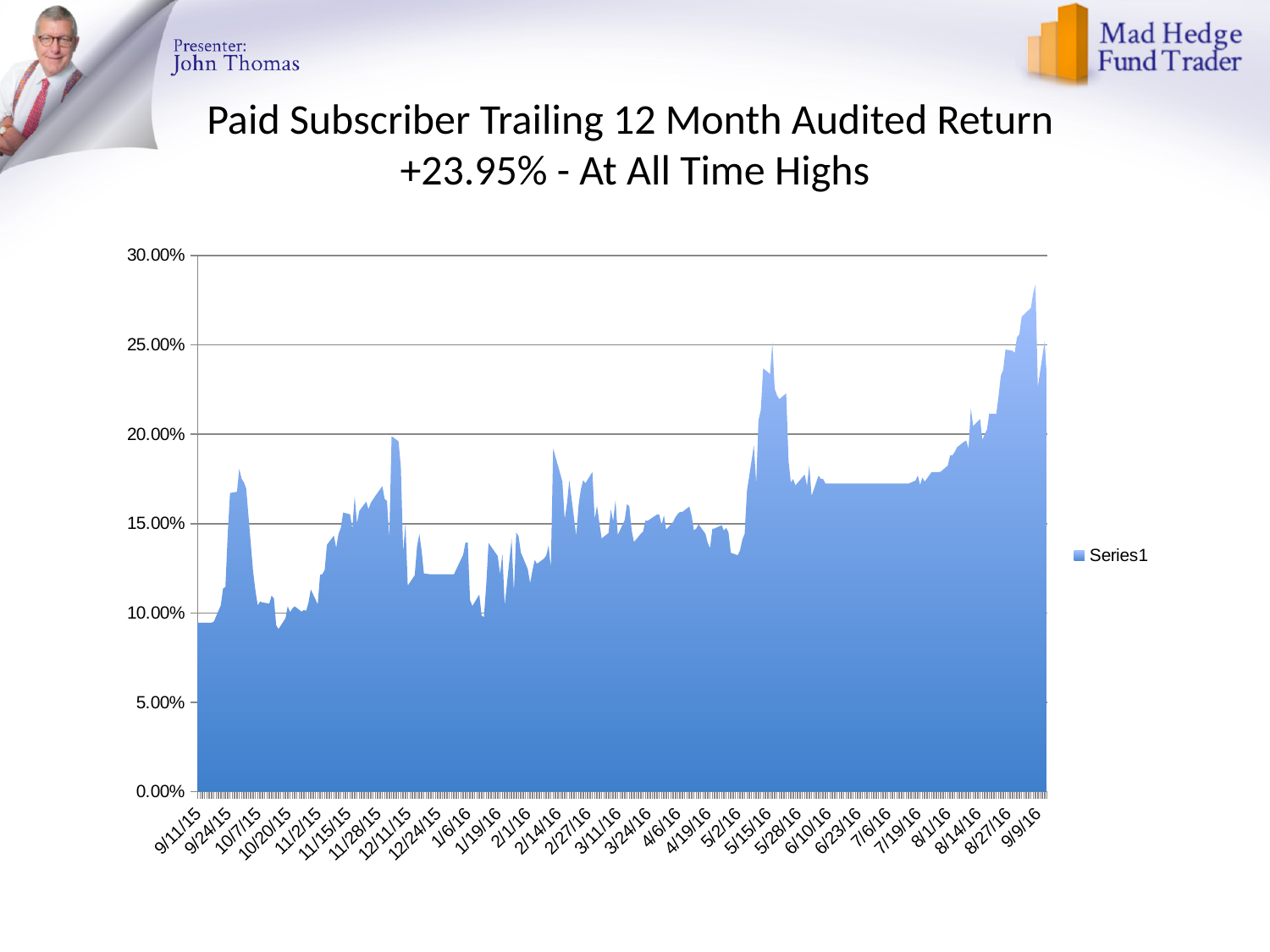
Is the value for 9/11/15 greater or less than 10.00%? less Is the highest point on the chart greater or less than 30.00%? less What kind of chart is shown on the slide? Area chart Is the value for 7/6/16 greater or less than 20.00%? less What is the title of the chart on the slide? Paid Subscriber Trailing 12 Month Audited Return +23.95% - At All Time Highs How many series does the legend list? 1 What is the name of the series shown in the legend? Series1 Overall, does the value rise or fall from 9/11/15 to 9/9/16? rise Which is larger, the value for 9/11/15 or the value for 9/9/16? 9/9/16